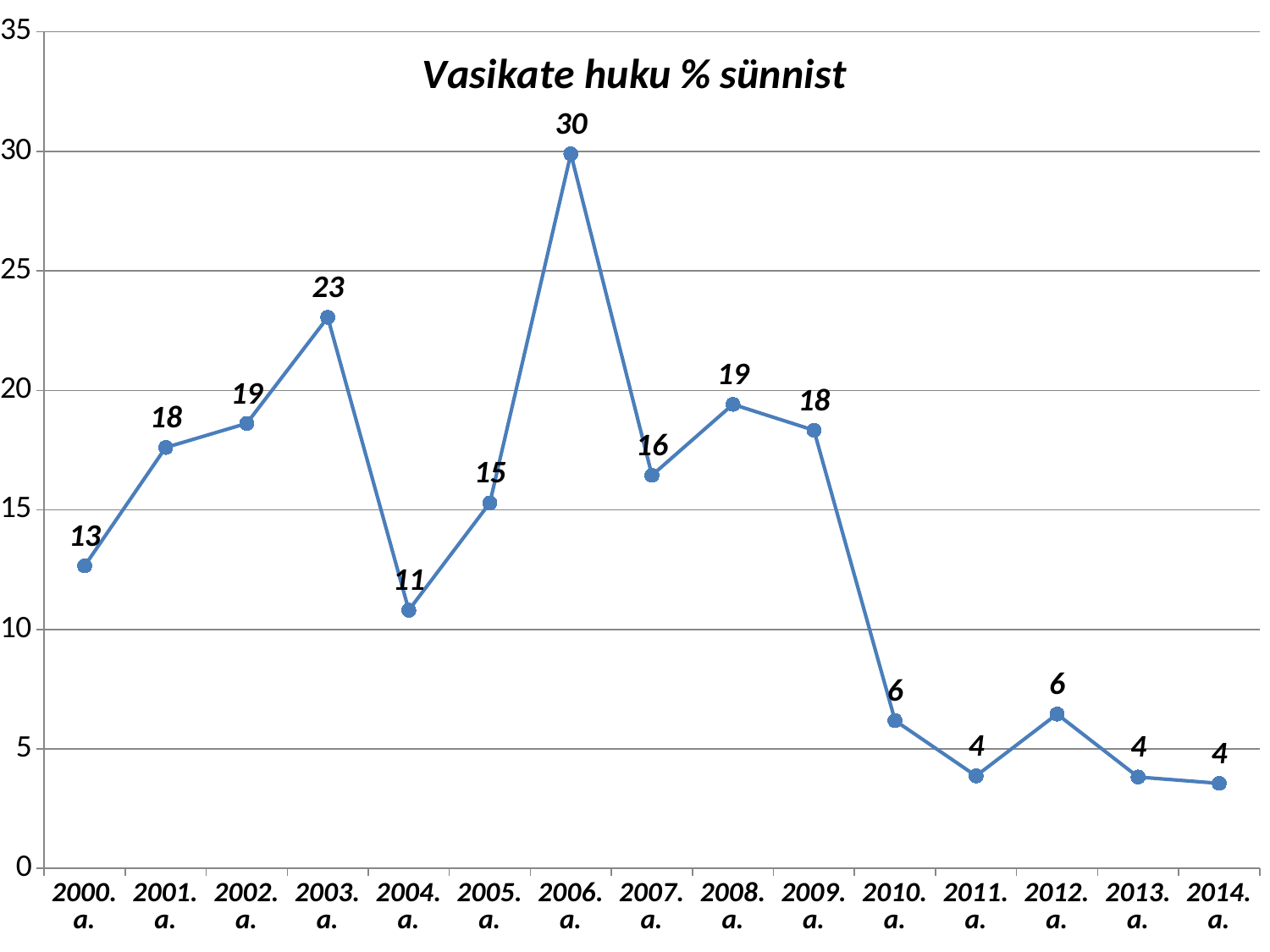
Is the value for 2009. a. greater or less than 15? greater What is the value for 2006. a.? 30 What is the value for 2010. a.? 6 What is the difference between the values for 2006. a. and 2004. a.? 19 Which is larger, the value for 2003. a. or the value for 2009. a.? 2003. a. What is the value for 2000. a.? 13 How many years are plotted on the chart? 15 What is the title of the chart? Vasikate huku % sünnist What kind of chart is this? line chart Which year has the highest value? 2006. a. Do the values rise or fall from 2009. a. to 2011. a.? fall Is the value for 2011. a. greater or less than 5? less